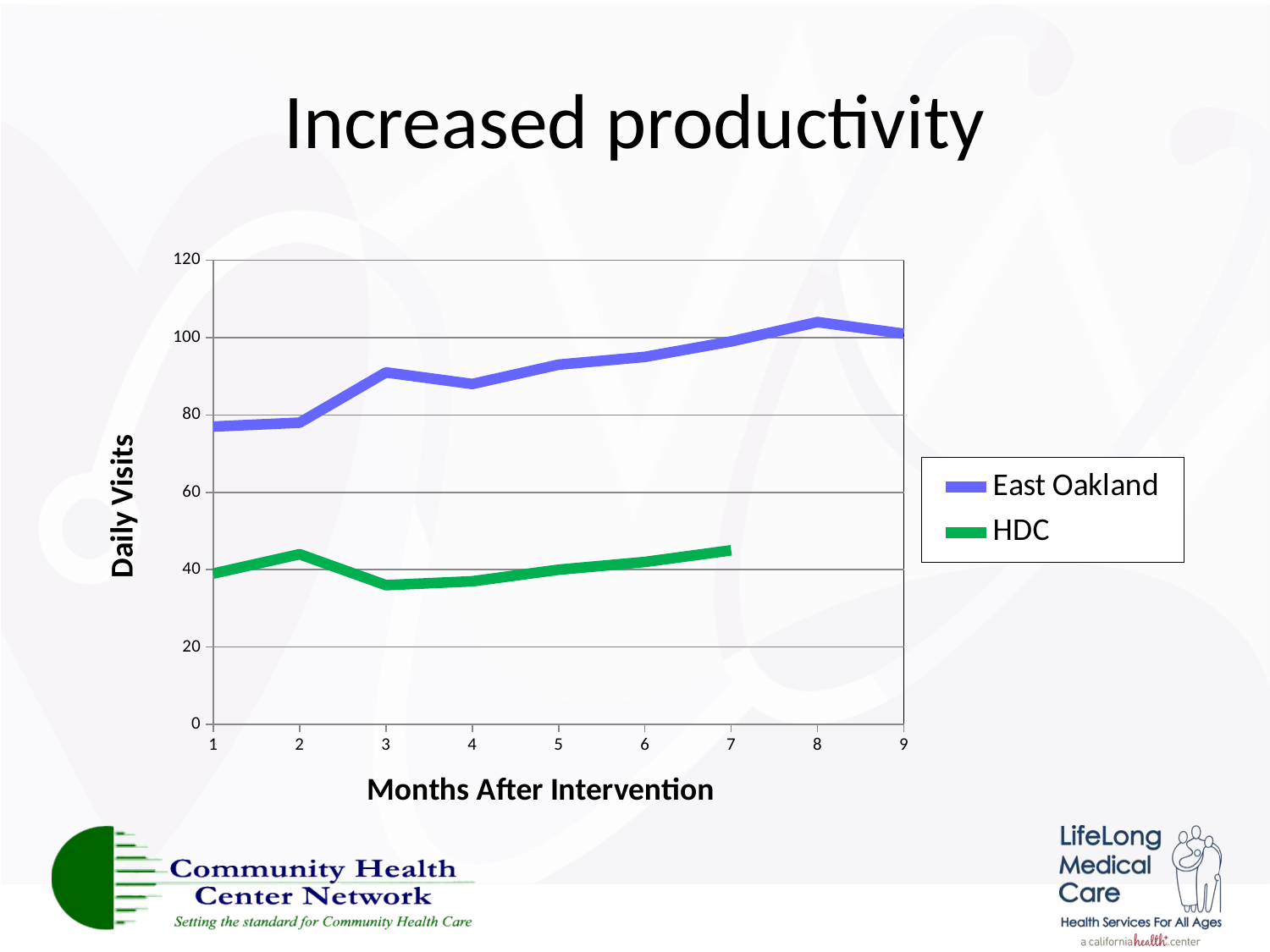
What is the label on the vertical axis? Daily Visits How many series does the legend list? 2 At which month does the East Oakland series reach its highest value? 8 What kind of chart is shown on the slide? line chart How many months are plotted for the East Oakland series? 9 How many months are plotted for the HDC series? 7 Is the East Oakland value at month 8 greater or less than 100? greater Does the East Oakland series generally rise or fall from month 1 to month 9? rise Is the HDC value at month 3 greater or less than 40? less At month 5, which series has the higher daily visits, East Oakland or HDC? East Oakland Is the East Oakland value at month 1 greater or less than 80? less